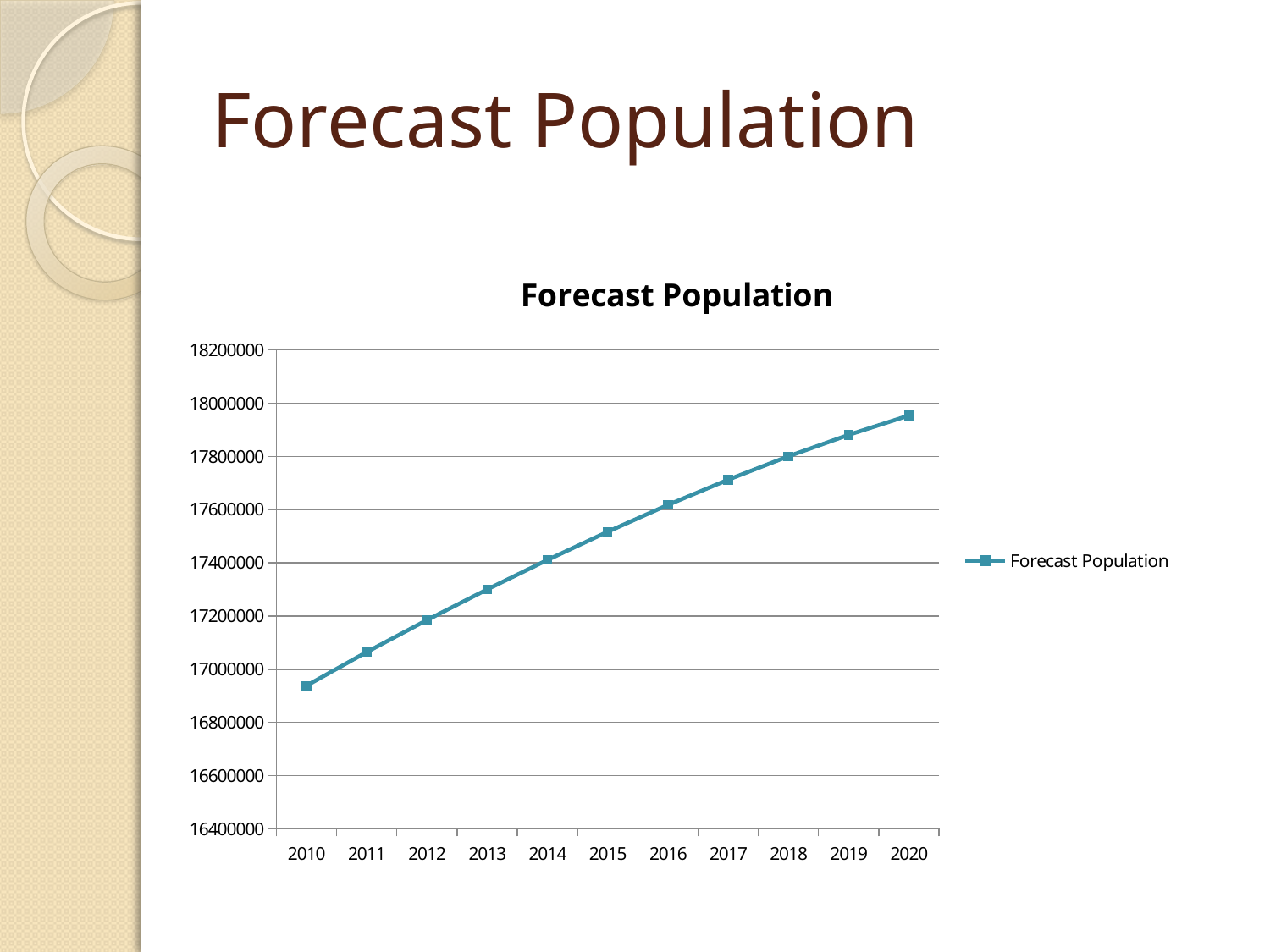
What kind of chart is shown on the slide? line chart Which year has the lowest forecast population? 2010 Which year has the highest forecast population? 2020 Do the forecast population values rise or fall from 2010 to 2020? rise What is the title of the chart? Forecast Population Is the forecast population for 2015 greater or less than 17400000? greater Which year has the larger forecast population, 2012 or 2016? 2016 Is the forecast population for 2020 greater or less than 18000000? less How many years are plotted on the x axis? 11 Is the forecast population for 2010 greater or less than 17000000? less How many series does the legend list? 1